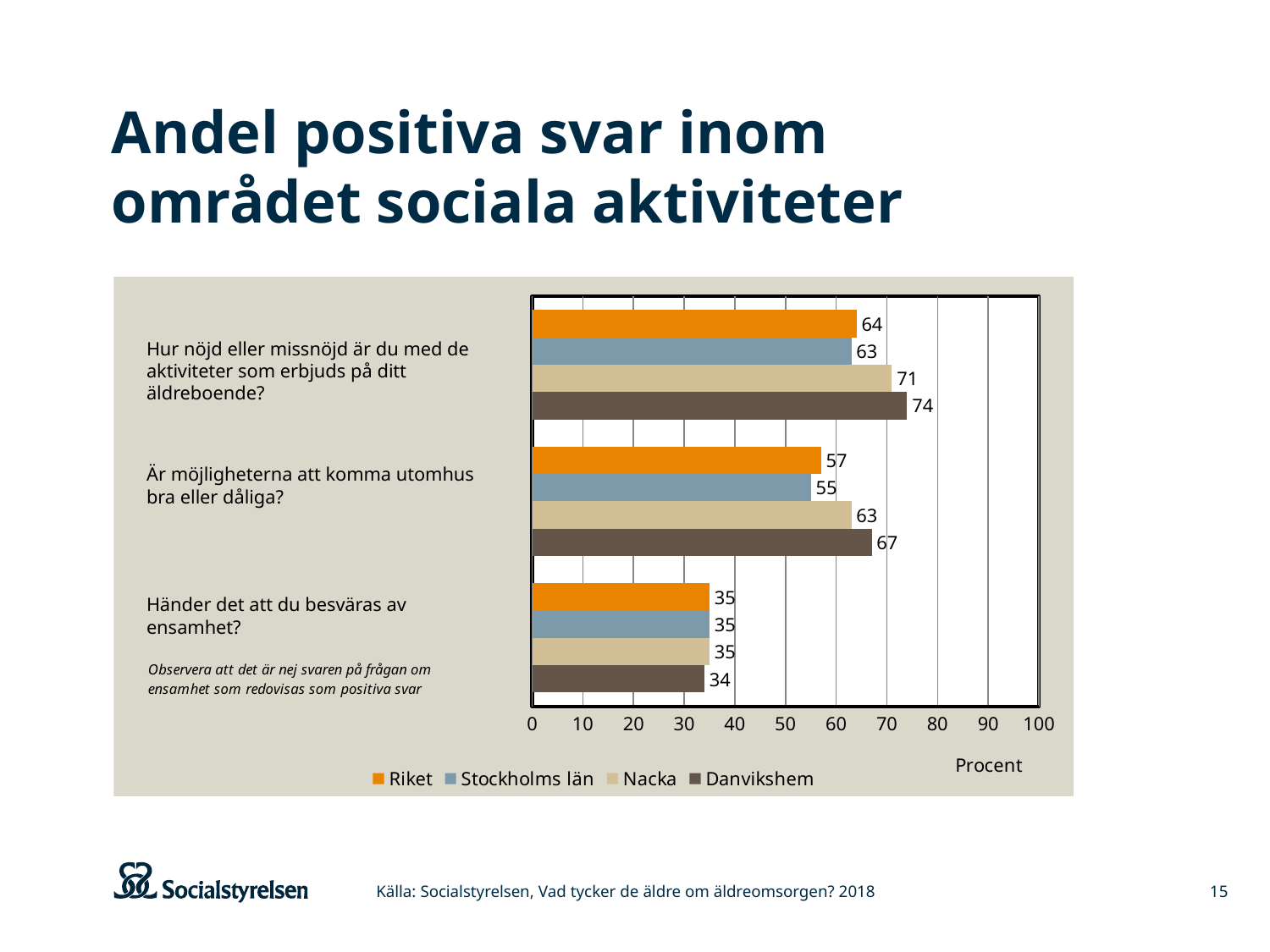
What is the label on the horizontal axis of the chart? Procent What is the difference between the Danvikshem and Riket values on the question "Hur nöjd eller missnöjd är du med de aktiviteter som erbjuds på ditt äldreboende?"? 10 Which series has the lowest value on the question "Händer det att du besväras av ensamhet?"? Danvikshem How many series does the legend list? 4 What is the difference between the Nacka and Stockholms län values on the question "Är möjligheterna att komma utomhus bra eller dåliga?"? 8 Which series has the highest value on the question "Är möjligheterna att komma utomhus bra eller dåliga?"? Danvikshem What is the value for Riket on the question "Är möjligheterna att komma utomhus bra eller dåliga?"? 57 How many questions (categories) are shown on the chart? 3 What is the value for Stockholms län on the question "Händer det att du besväras av ensamhet?"? 35 What is the value for Danvikshem on the question "Hur nöjd eller missnöjd är du med de aktiviteter som erbjuds på ditt äldreboende?"? 74 What kind of chart is shown on the slide? Bar chart Which is larger on the question "Är möjligheterna att komma utomhus bra eller dåliga?": Nacka or Stockholms län? Nacka